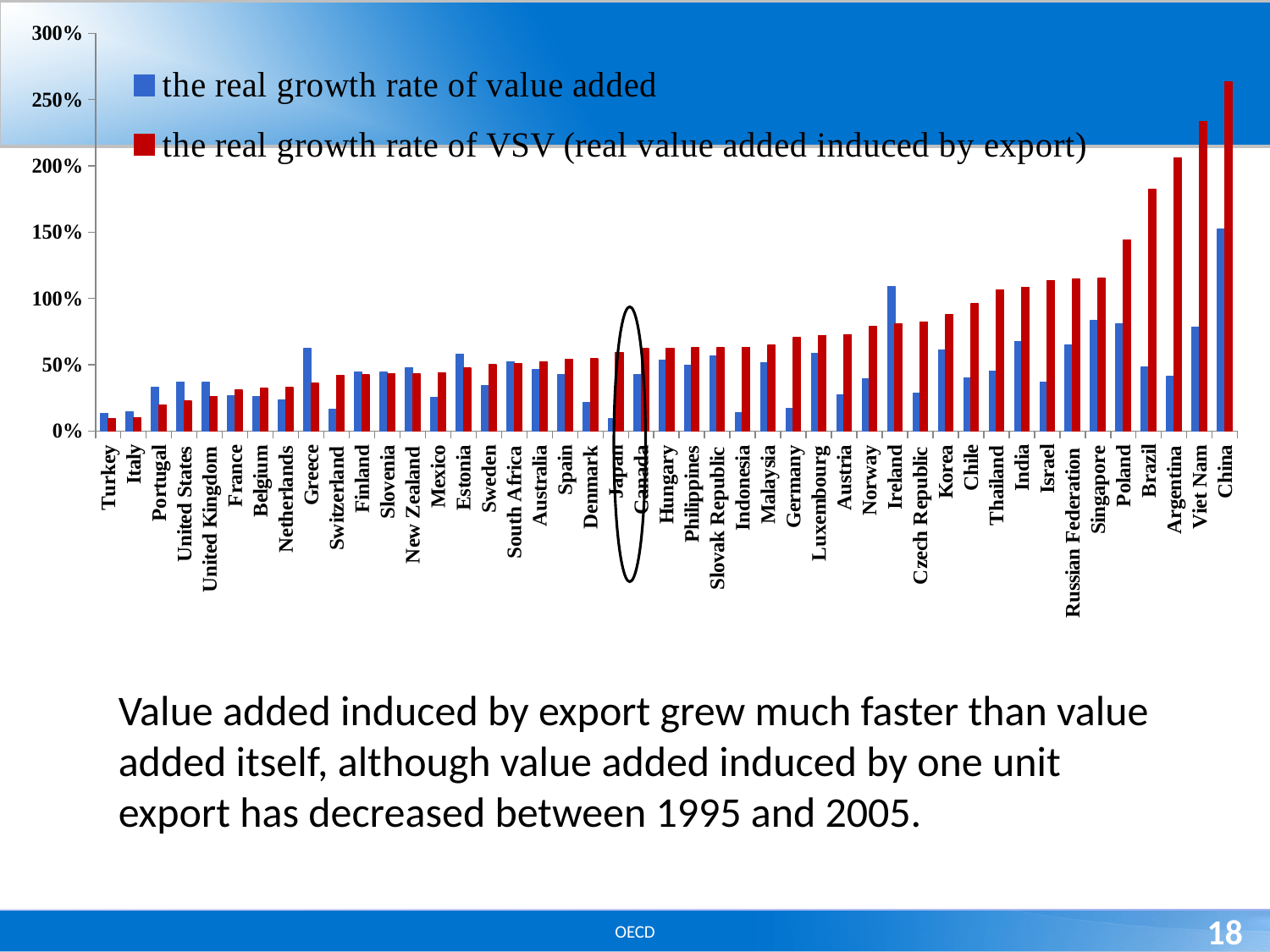
Is the real growth rate of VSV for Turkey greater or less than 50%? less Is the real growth rate of VSV for Viet Nam greater or less than 200%? greater How many series does the legend list? 2 For Ireland, which is larger: the real growth rate of value added or the real growth rate of VSV? the real growth rate of value added What kind of chart is shown on the slide? bar chart Which country has the highest real growth rate of value added (blue bar)? China How many countries are shown on the x axis? 45 Is the real growth rate of value added for Ireland greater or less than 100%? greater Which country has the highest real growth rate of VSV (red bar)? China Do the red bars (real growth rate of VSV) generally rise or fall from left to right along the x axis? rise Which country is circled on the chart? Japan